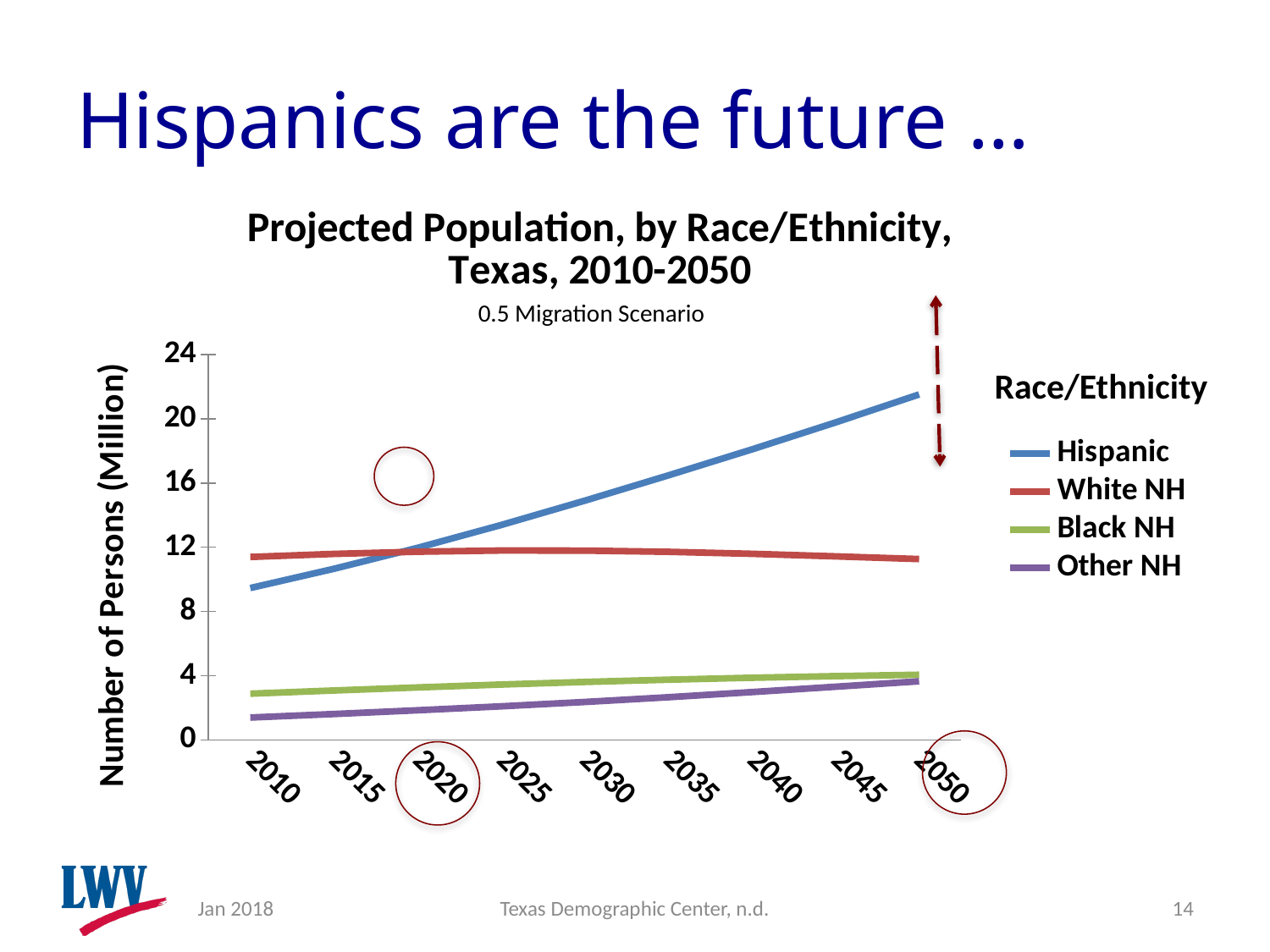
Is the Hispanic value for 2050 greater or less than 20? greater In 2050, which is larger: the Hispanic value or the White NH value? Hispanic What kind of chart is shown on the slide? Line chart Does the Hispanic line rise or fall from 2010 to 2050? Rises Which race/ethnicity group has the lowest projected population in 2010? Other NH Which race/ethnicity group has the highest projected population in 2050? Hispanic What is the subtitle shown under the chart title? 0.5 Migration Scenario How many years are labelled along the x axis? 9 Which race/ethnicity group has the highest projected population in 2010? White NH How many series does the legend list? 4 Is the Hispanic value for 2010 greater or less than 12? less Is the Black NH value for 2010 greater or less than 4? less